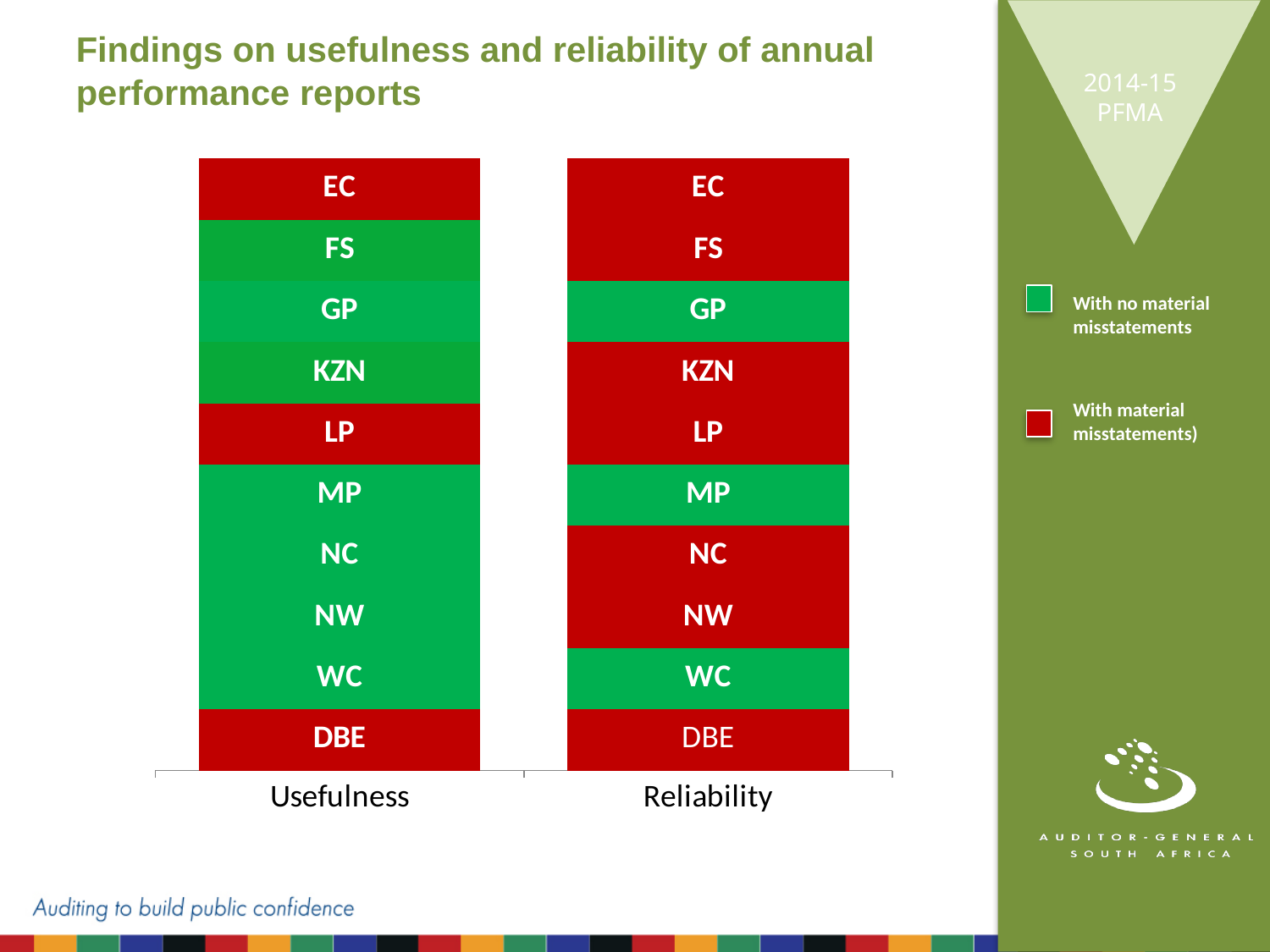
What are the two categories labelled on the x axis of the chart? Usefulness and Reliability What finding does the EC segment of the Usefulness bar show? With material misstatements How many segments (provinces/departments) make up the Usefulness bar? 10 What kind of chart is shown on the slide? Stacked bar chart How many bars are shown along the x axis of the chart? 2 What does the green colour in the legend represent? With no material misstatements What is the title of the slide containing the chart? Findings on usefulness and reliability of annual performance reports How many segments in the Reliability bar are green (with no material misstatements)? 3 What finding does the FS segment of the Reliability bar show? With material misstatements What finding does the FS segment of the Usefulness bar show? With no material misstatements Which bar, Usefulness or Reliability, has more segments with material misstatements? Reliability